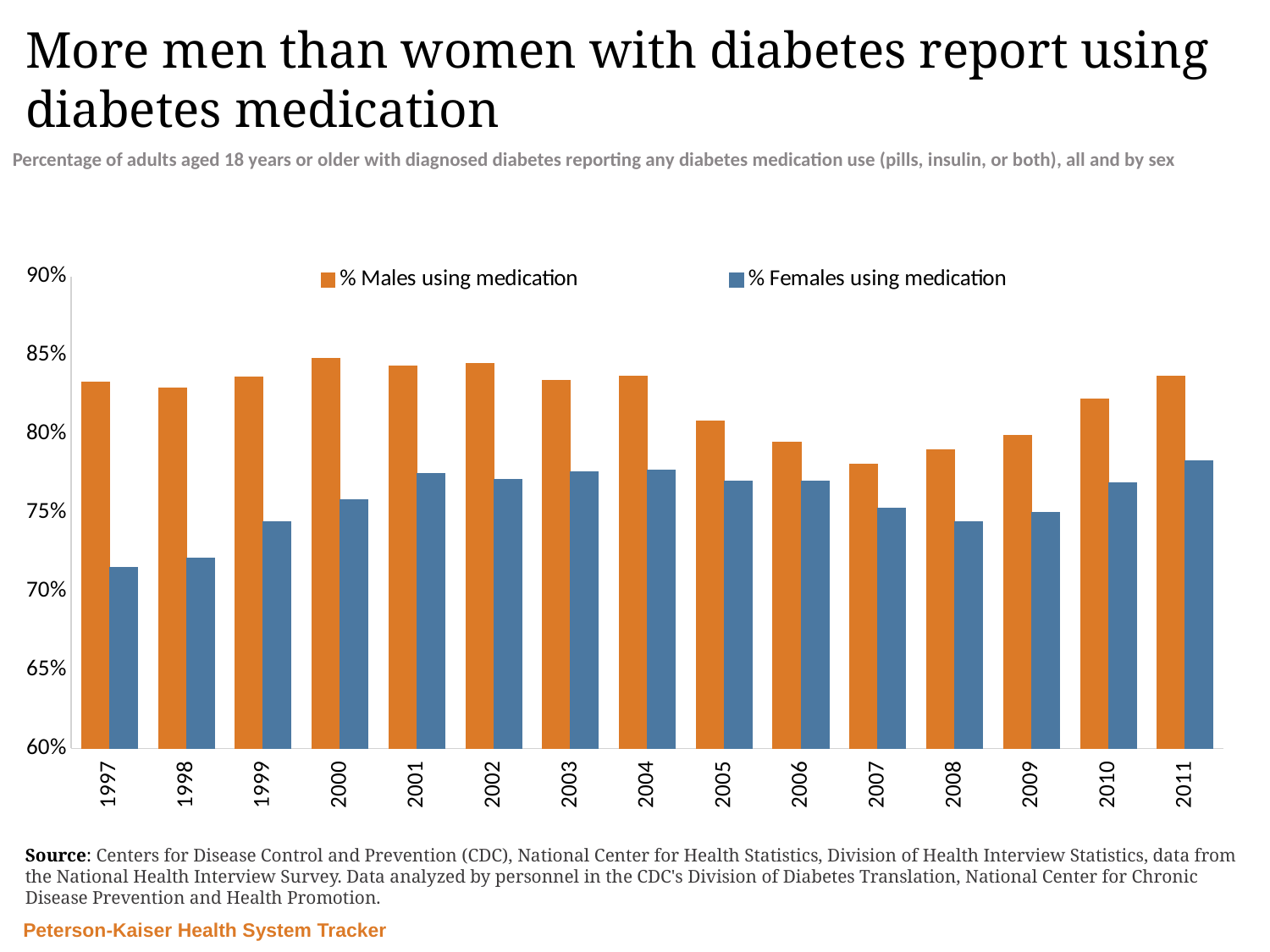
What kind of chart is shown on the slide? bar chart Do the values for % Males using medication rise or fall from 2004 to 2007? fall Is the value for % Females using medication in 2011 greater or less than 75%? greater Is the value for % Females using medication in 1997 greater or less than 75%? less Is the value for % Males using medication in 2007 greater or less than 80%? less Which year has the lowest value for % Males using medication? 2007 In 2005, which is larger: % Males using medication or % Females using medication? % Males using medication How many series does the legend list? 2 Which colour represents % Females using medication in the chart? blue How many years are shown on the x axis? 15